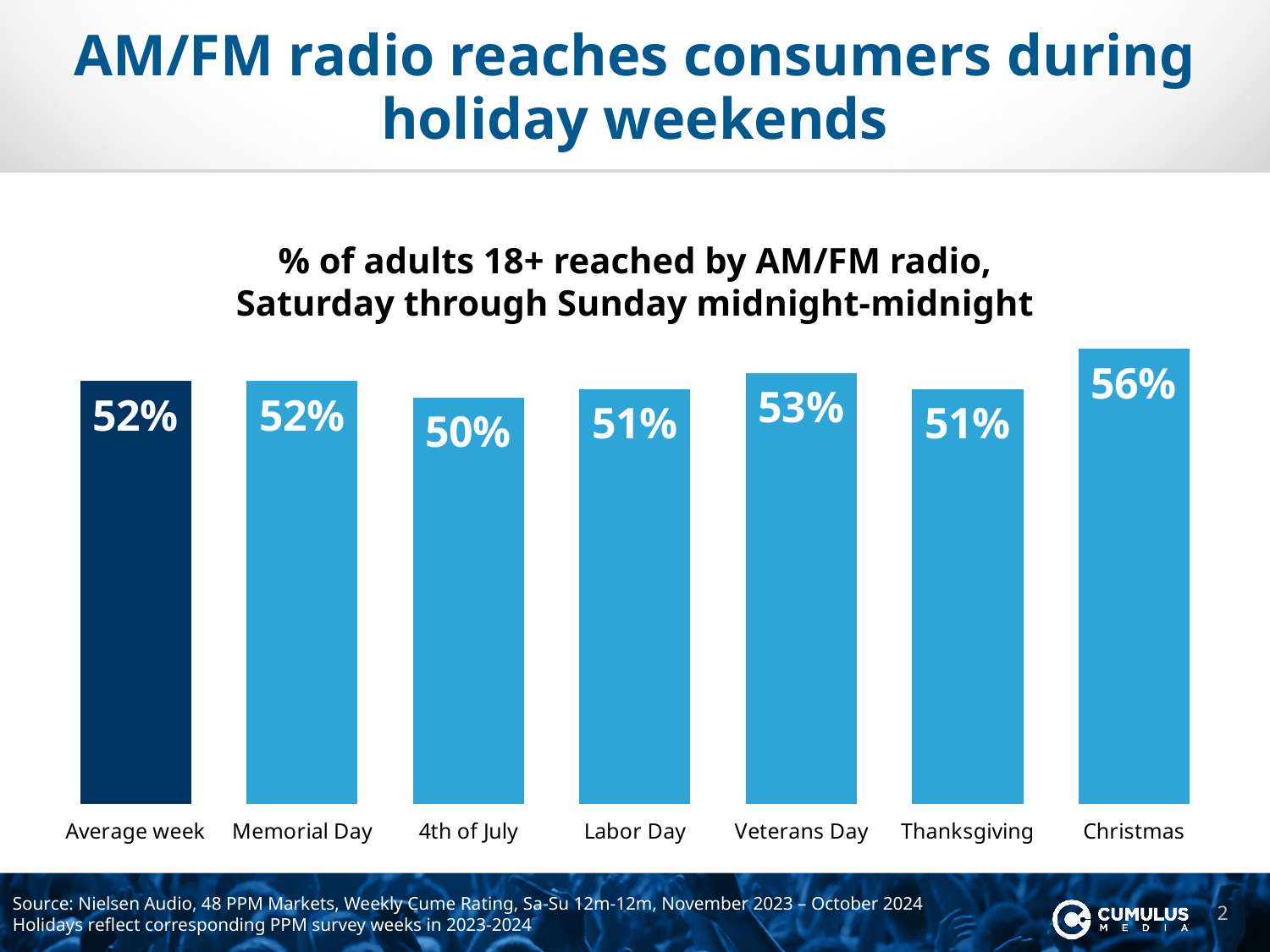
Which is larger, the value for Christmas or the value for Veterans Day? Christmas What kind of chart is shown on the slide? Bar chart How many categories are shown on the chart? 7 What is the value shown for the Average week bar? 52% What percentage of adults 18+ are reached by AM/FM radio during the Christmas weekend? 56% What is the value for 4th of July? 50% Which holiday weekend has the highest reach? Christmas What is the difference between the Christmas value and the Average week value? 4% Which category has the lowest value on the chart? 4th of July What is the difference between the Veterans Day value and the 4th of July value? 3% What percentage is shown for Veterans Day? 53% Which bar is shown in a darker blue than the others? Average week